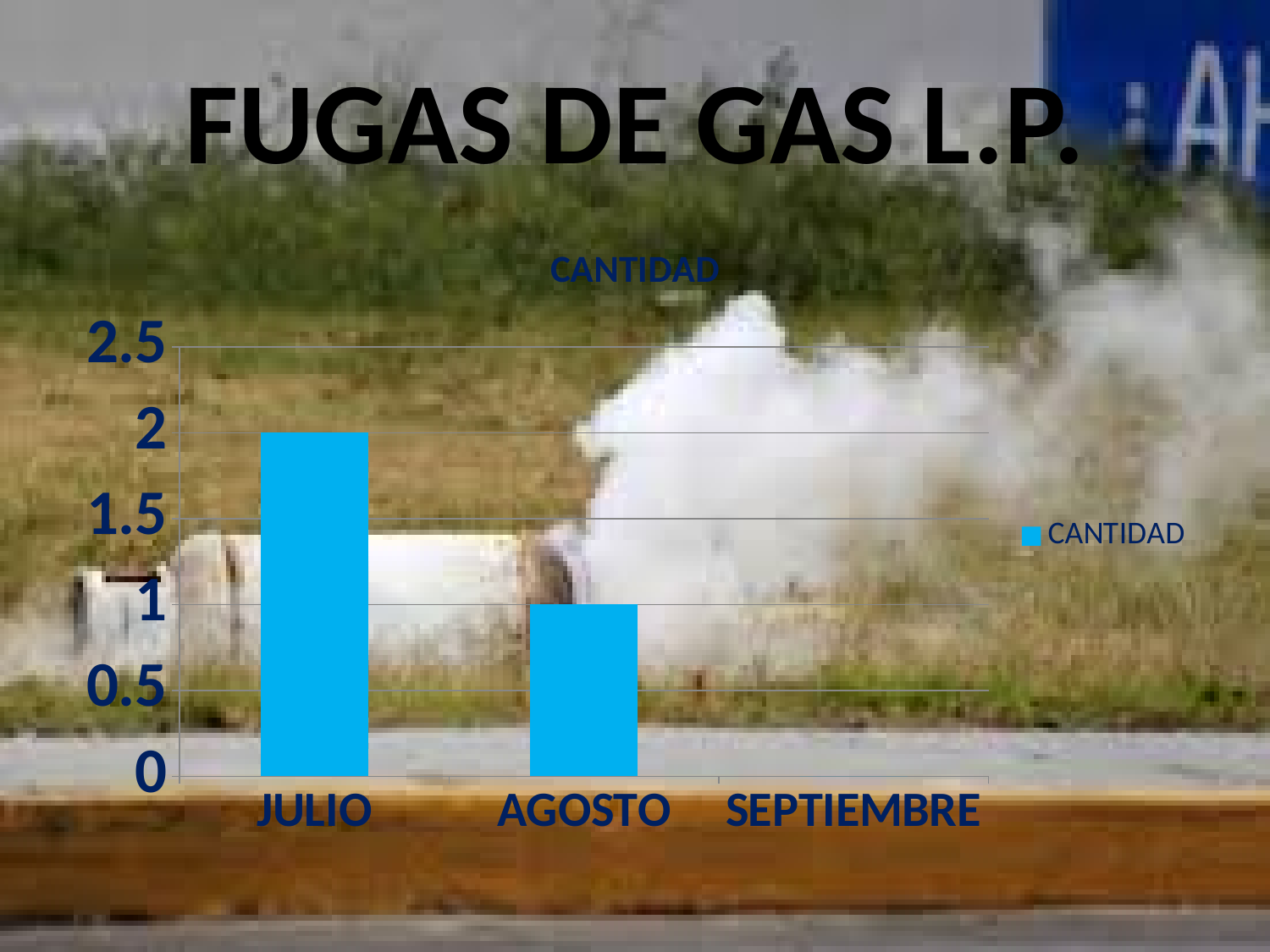
Do the values rise or fall from JULIO to AGOSTO? fall What is the difference between the values for JULIO and AGOSTO? 1 What kind of chart is shown? bar chart Which month has the highest value? JULIO What is the value for AGOSTO? 1 What is the title of the chart? CANTIDAD How many series does the legend list? 1 Is the value for AGOSTO greater or less than 1.5? less Which is larger, the value for JULIO or the value for AGOSTO? JULIO What is the value for JULIO? 2 Is the value for JULIO greater or less than 1.5? greater How many categories are shown on the x axis? 3